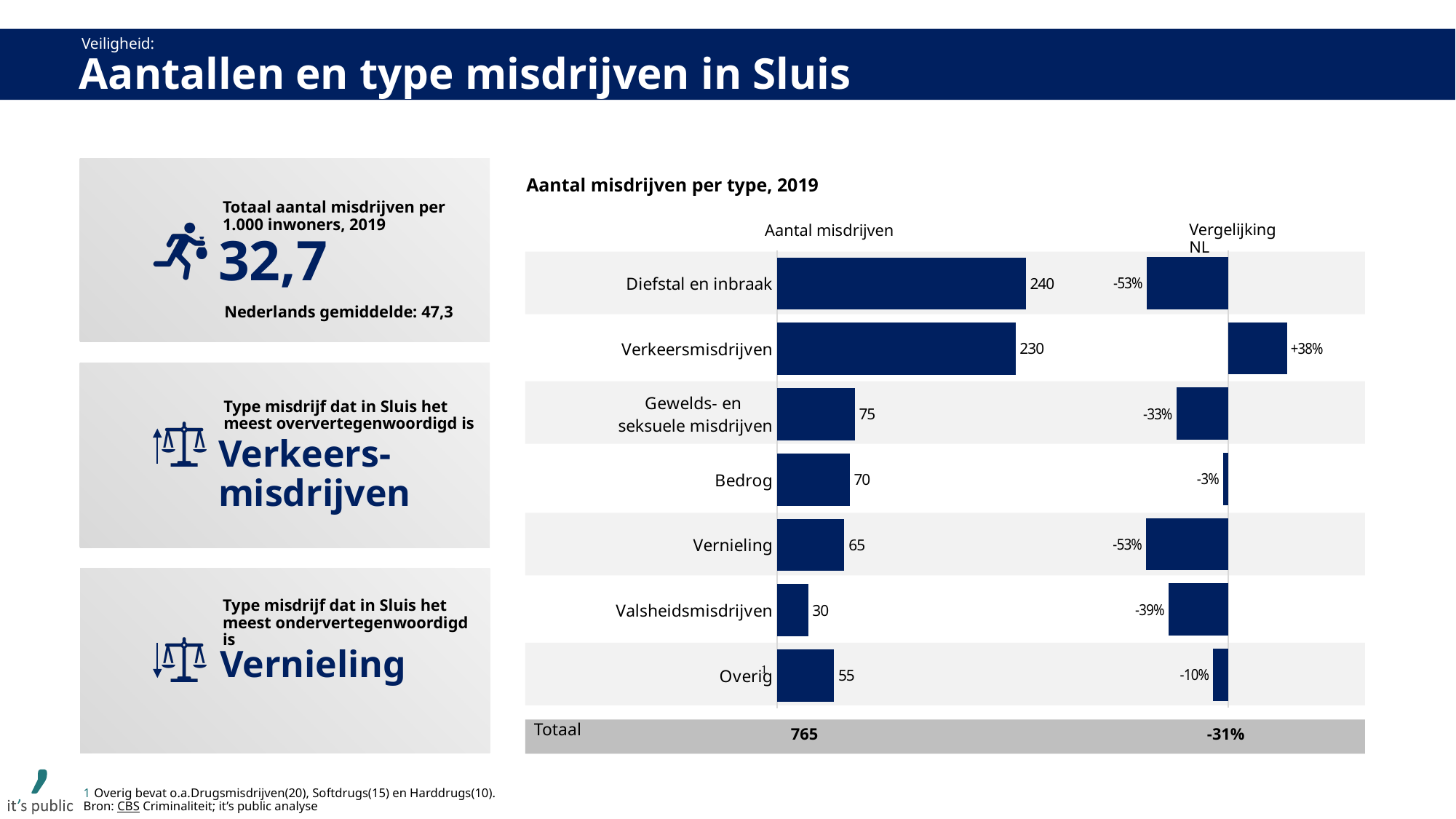
In the chart 'Aantal misdrijven per type, 2019', what is the number of crimes (Aantal misdrijven) for Diefstal en inbraak? 240 In the chart 'Aantal misdrijven per type, 2019', what is the Vergelijking NL value for Verkeersmisdrijven? +38% In the chart 'Aantal misdrijven per type, 2019', which crime type has the lowest number of crimes? Valsheidsmisdrijven In the chart 'Aantal misdrijven per type, 2019', what is the total number of crimes shown in the Totaal row? 765 What kind of chart is 'Aantal misdrijven per type, 2019'? Bar chart In the chart 'Aantal misdrijven per type, 2019', which has more crimes: Bedrog or Vernieling? Bedrog In the chart 'Aantal misdrijven per type, 2019', which crime type has the highest number of crimes? Diefstal en inbraak In the chart 'Aantal misdrijven per type, 2019', what is the difference in number of crimes between Diefstal en inbraak and Verkeersmisdrijven? 10 In the chart 'Aantal misdrijven per type, 2019', what is the Vergelijking NL value in the Totaal row? -31% In the chart 'Aantal misdrijven per type, 2019', what is the Vergelijking NL value for Bedrog? -3% In the chart 'Aantal misdrijven per type, 2019', what is the number of crimes for Valsheidsmisdrijven? 30 In the chart 'Aantal misdrijven per type, 2019', how many crime types are listed (excluding the Totaal row)? 7